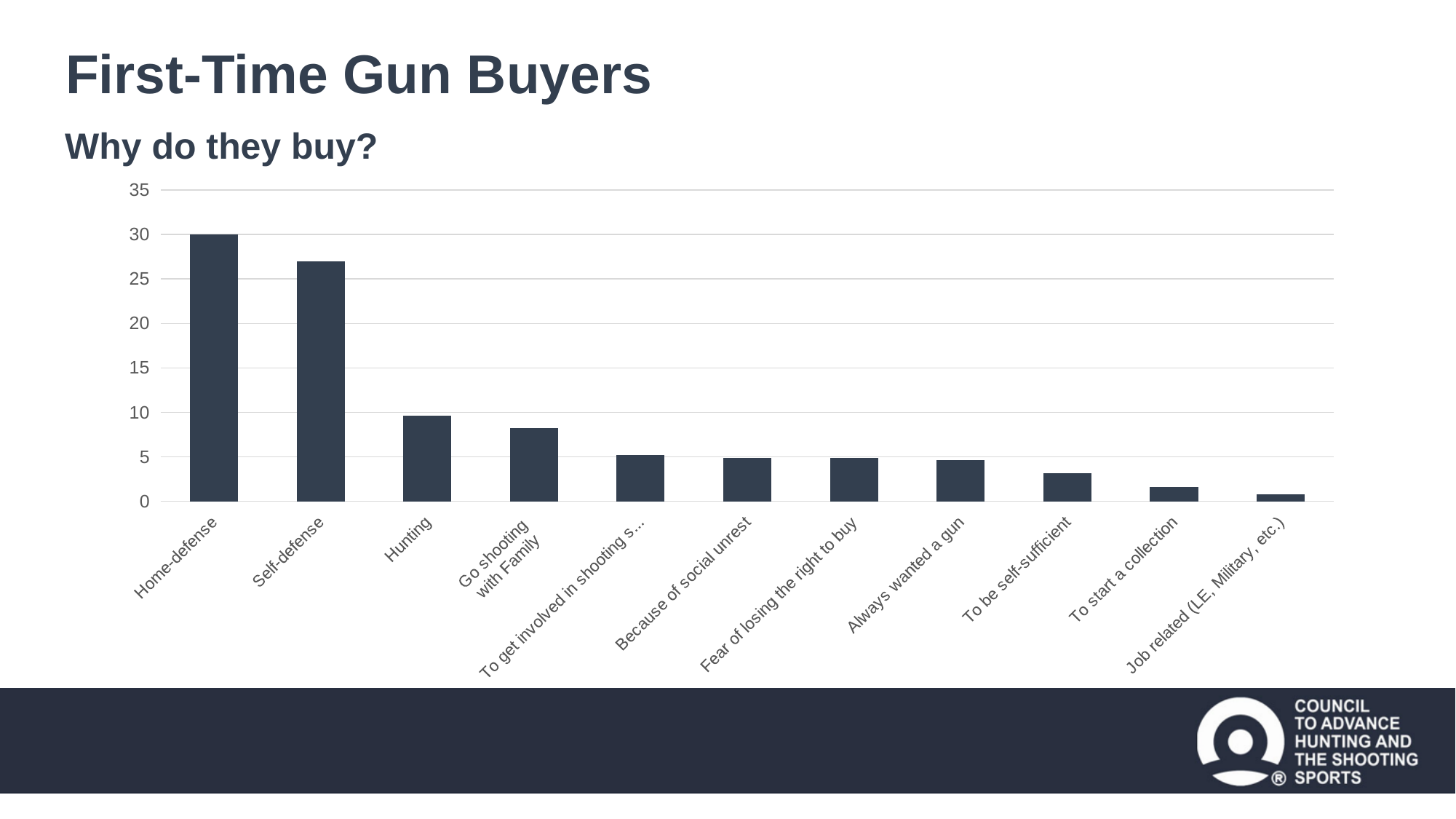
Which reason has the lowest value on the chart? Job related (LE, Military, etc.) Do the values rise or fall moving from left to right along the x axis? fall Which is larger, the value for Hunting or the value for Go shooting with Family? Hunting How many categories (reasons) are shown on the chart? 11 Is the value for Self-defense greater or less than 25? greater What is the value for Home-defense? 30 What kind of chart is shown on the slide? bar chart Is the value for To be self-sufficient greater or less than 5? less What is the subtitle shown above the chart? Why do they buy? Which reason has the highest value on the chart? Home-defense Is the value for Go shooting with Family greater or less than 5? greater